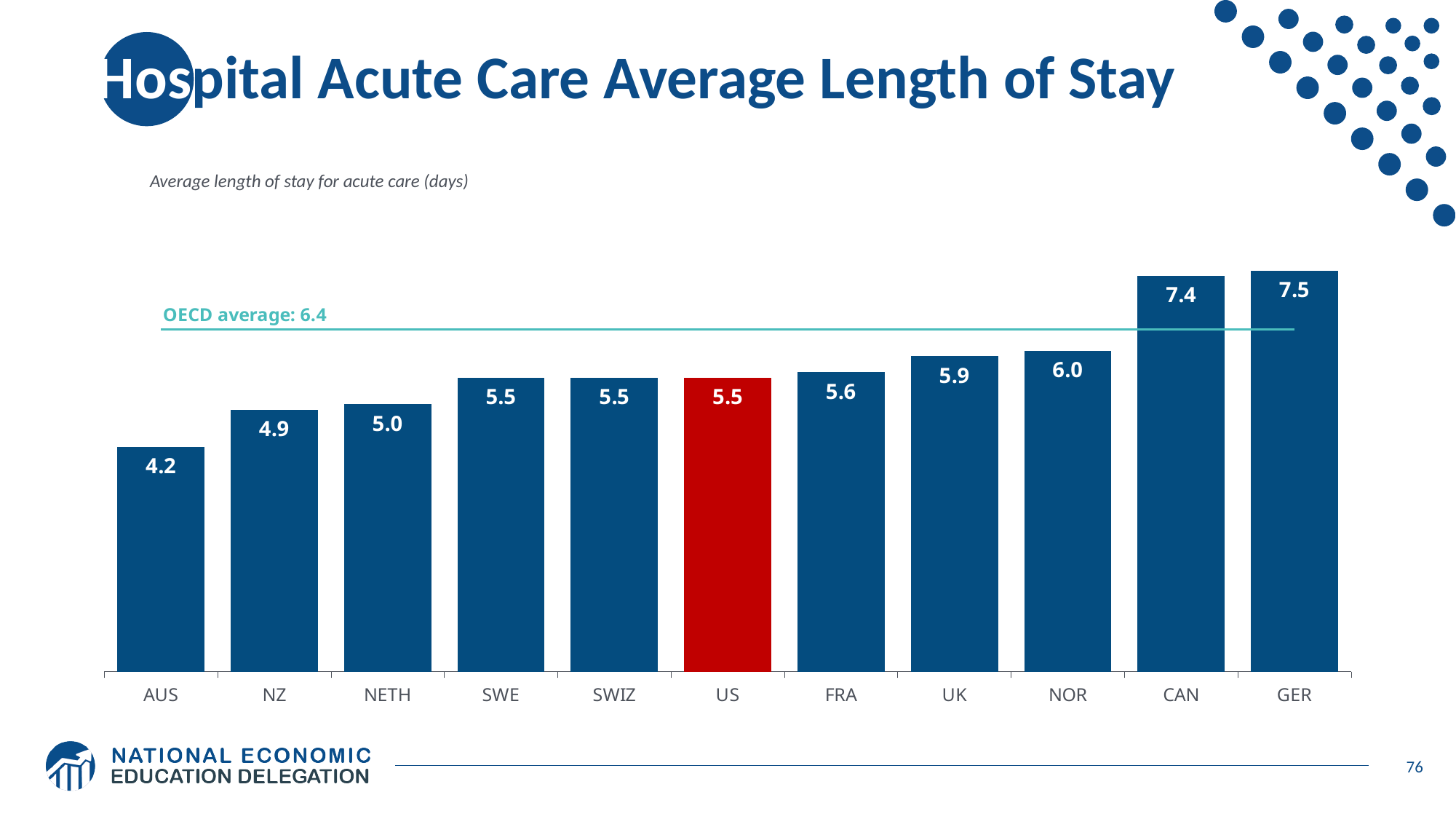
What is the average length of stay for acute care in Germany (GER)? 7.5 What is the average length of stay for acute care in the US? 5.5 Which country's bar is highlighted in red? US What is the OECD average shown on the chart? 6.4 What is the difference between the values for CAN and AUS? 3.2 What is the difference between the values for NOR and NETH? 1.0 What kind of chart is shown on the slide? Bar chart What is the value shown for AUS? 4.2 Which country has the highest average length of stay for acute care? GER Which has a longer average length of stay, UK or FRA? UK Which country has the lowest average length of stay for acute care? AUS How many countries are shown on the chart? 11